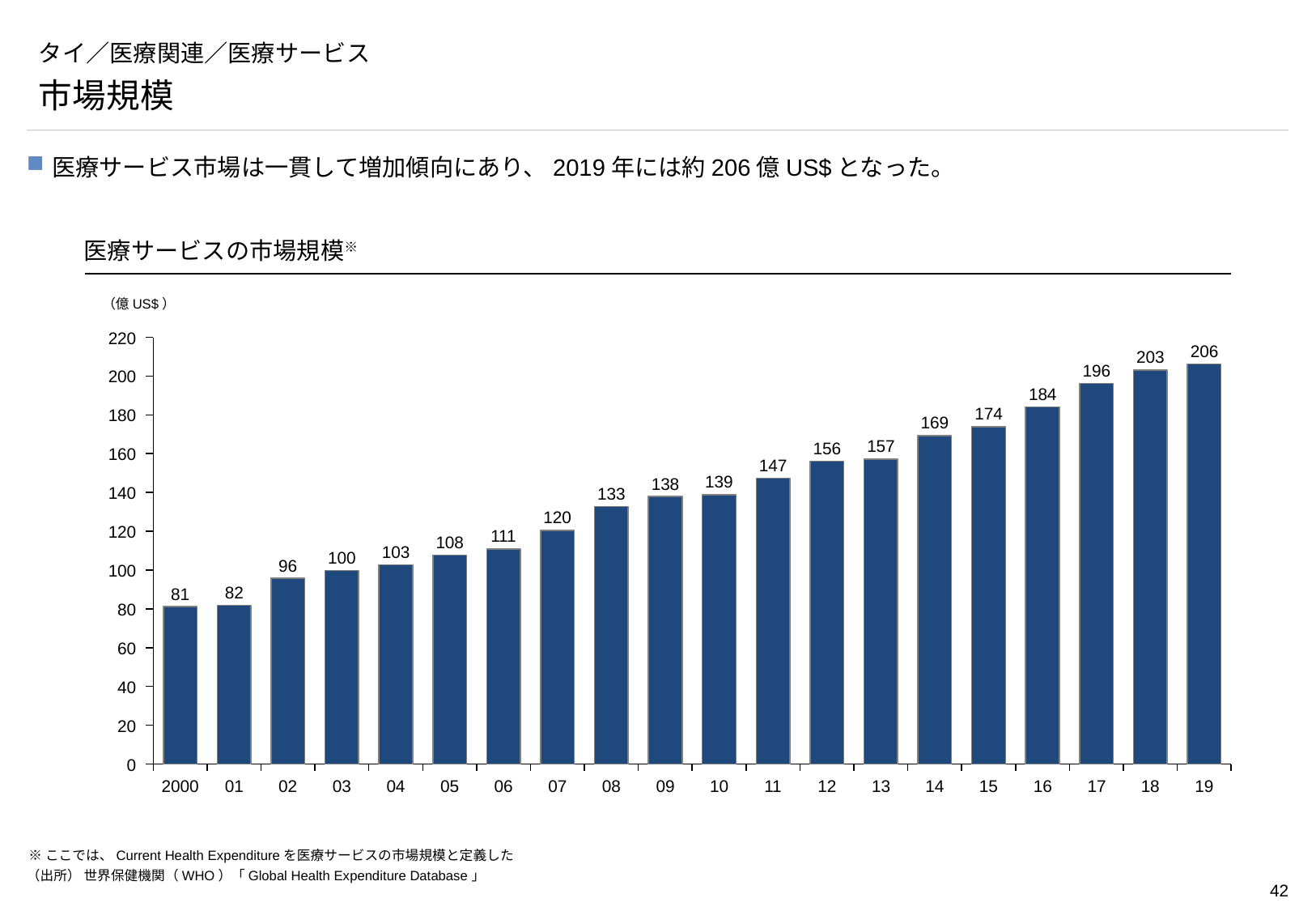
What is the value for 2010? 139 What kind of chart is this? bar chart Which is larger, the value for 2012 or the value for 2014? 2014 What unit is shown for the y axis? 億 US$ What is the value for 2000? 81 What is the difference between the values for 2019 and 2000? 125 Do the values rise or fall from 2000 to 2019? rise How many years are shown on the x axis? 20 What is the value for 2016? 184 What is the difference between the values for 2008 and 2007? 13 Which year has the lowest value? 2000 Which year has the highest value? 2019